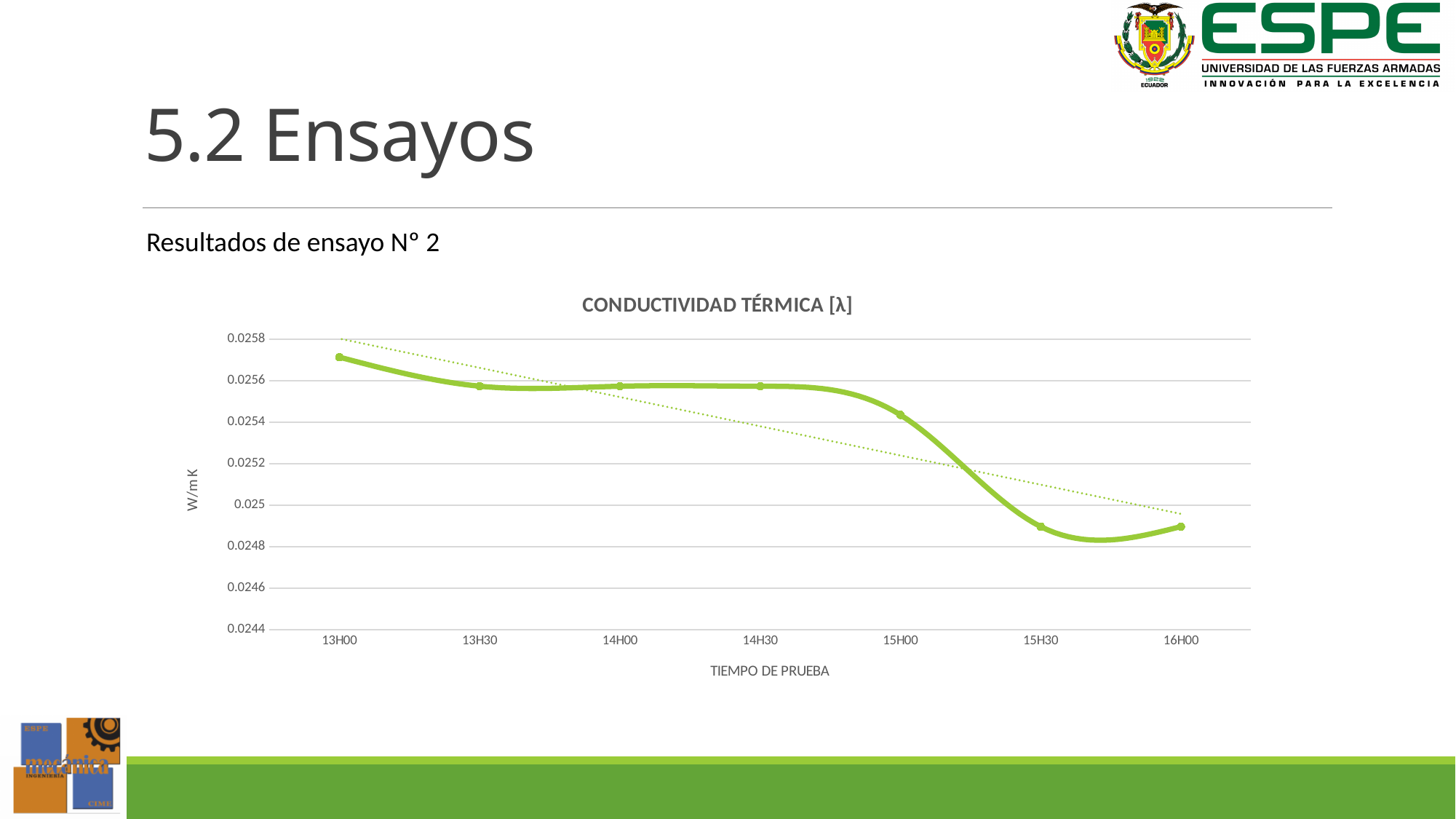
How many time points are plotted on the chart? 7 What kind of chart is shown on the slide? line chart Is the value at 14H00 greater or less than 0.0254? greater Which has the larger value, 13H00 or 15H30? 13H00 Is the value at 13H00 greater or less than 0.0256? greater Which has the larger value, 14H30 or 16H00? 14H30 What is the label of the x axis of the chart? TIEMPO DE PRUEBA What is the title of the chart? CONDUCTIVIDAD TÉRMICA [λ] Is the value at 15H30 greater or less than 0.025? less At which time is the thermal conductivity highest? 13H00 Do the values generally rise or fall from 13H00 to 16H00? fall